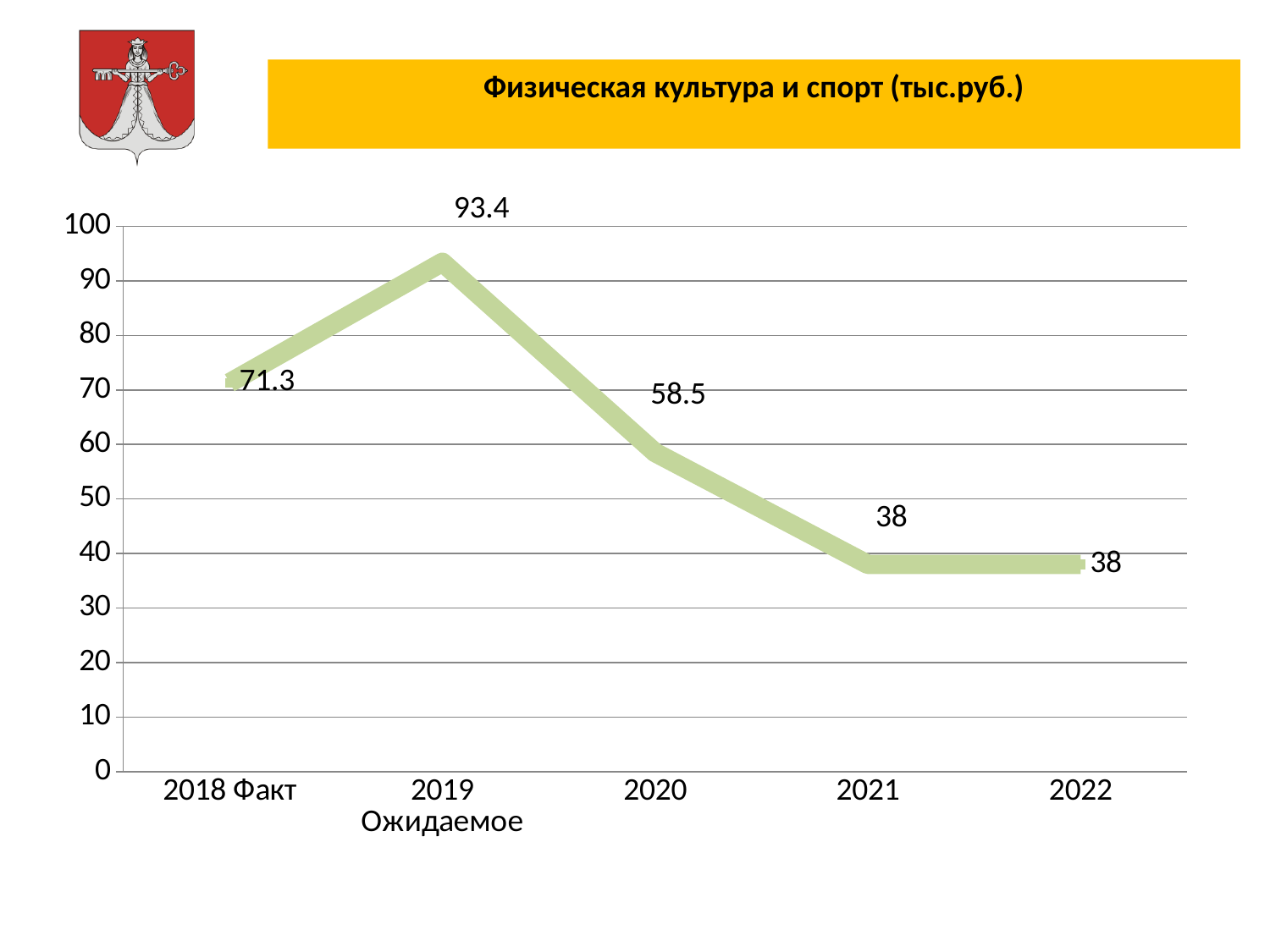
What kind of chart is shown on the slide? line chart What is the difference between the values for 2019 Ожидаемое and 2020? 34.9 Which is larger, the value for 2018 Факт or the value for 2020? 2018 Факт What is the value for 2019 Ожидаемое? 93.4 Is the value for 2021 greater or less than 40? less How many data points are plotted on the chart? 5 What is the title of the chart? Физическая культура и спорт (тыс.руб.) What is the value for 2020? 58.5 What is the value for 2022? 38 What is the value for 2018 Факт? 71.3 What is the difference between the values for 2018 Факт and 2021? 33.3 Which year has the highest value? 2019 Ожидаемое